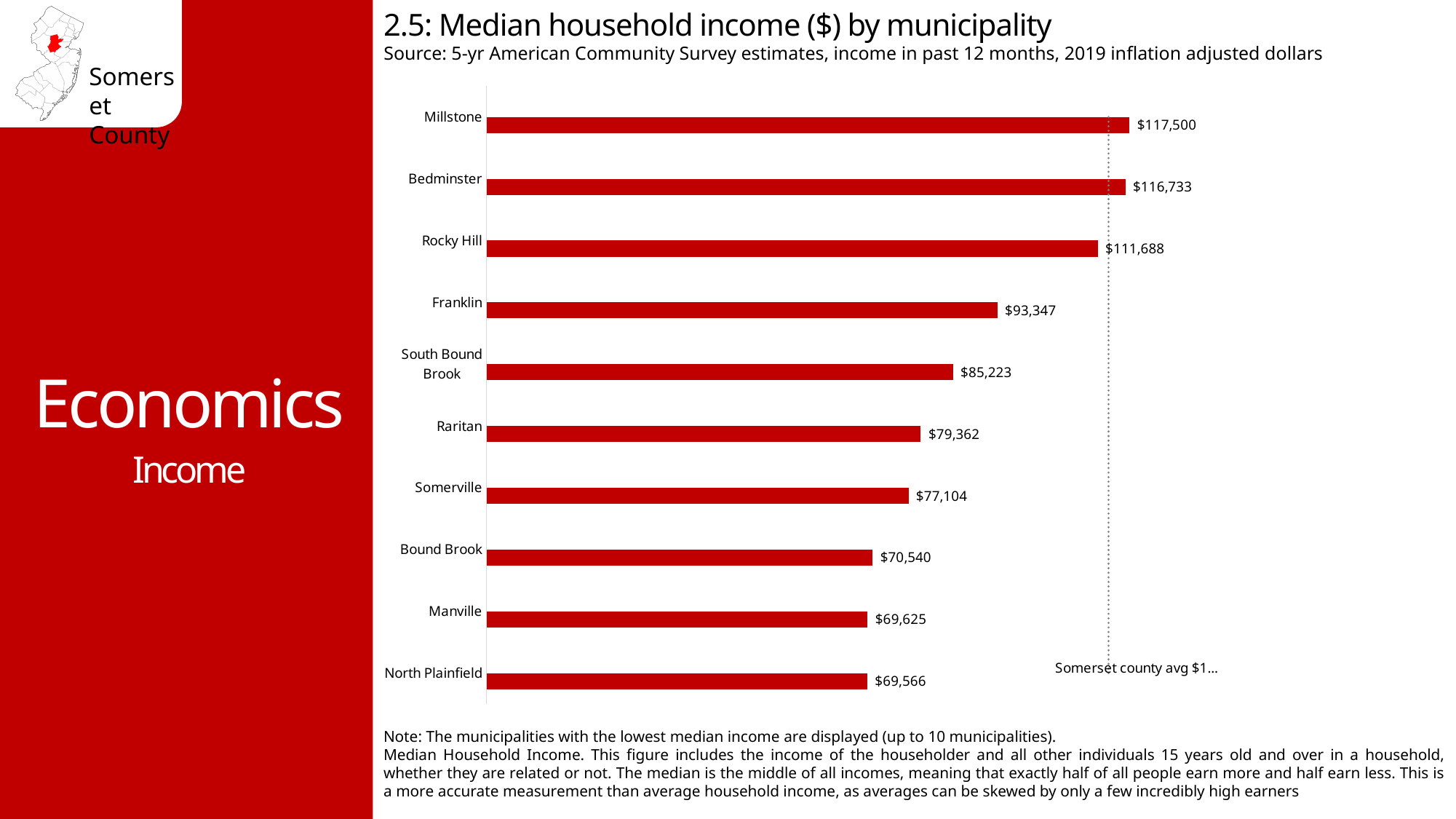
Which municipality has the highest median household income on the chart? Millstone What is the median household income for Franklin? $93,347 What type of chart is used to show median household income by municipality? Bar chart How much higher is Franklin's median household income than South Bound Brook's? $8,124 What is the title of the chart? 2.5: Median household income ($) by municipality Which has a higher median household income, Rocky Hill or Franklin? Rocky Hill What is the difference between the median household incomes of Millstone and Bedminster? $767 Which municipality has the lowest median household income on the chart? North Plainfield Which has a higher median household income, Raritan or Somerville? Raritan How many municipalities are shown on the chart? 10 What is the median household income shown for South Bound Brook? $85,223 What is the median household income for Bound Brook? $70,540